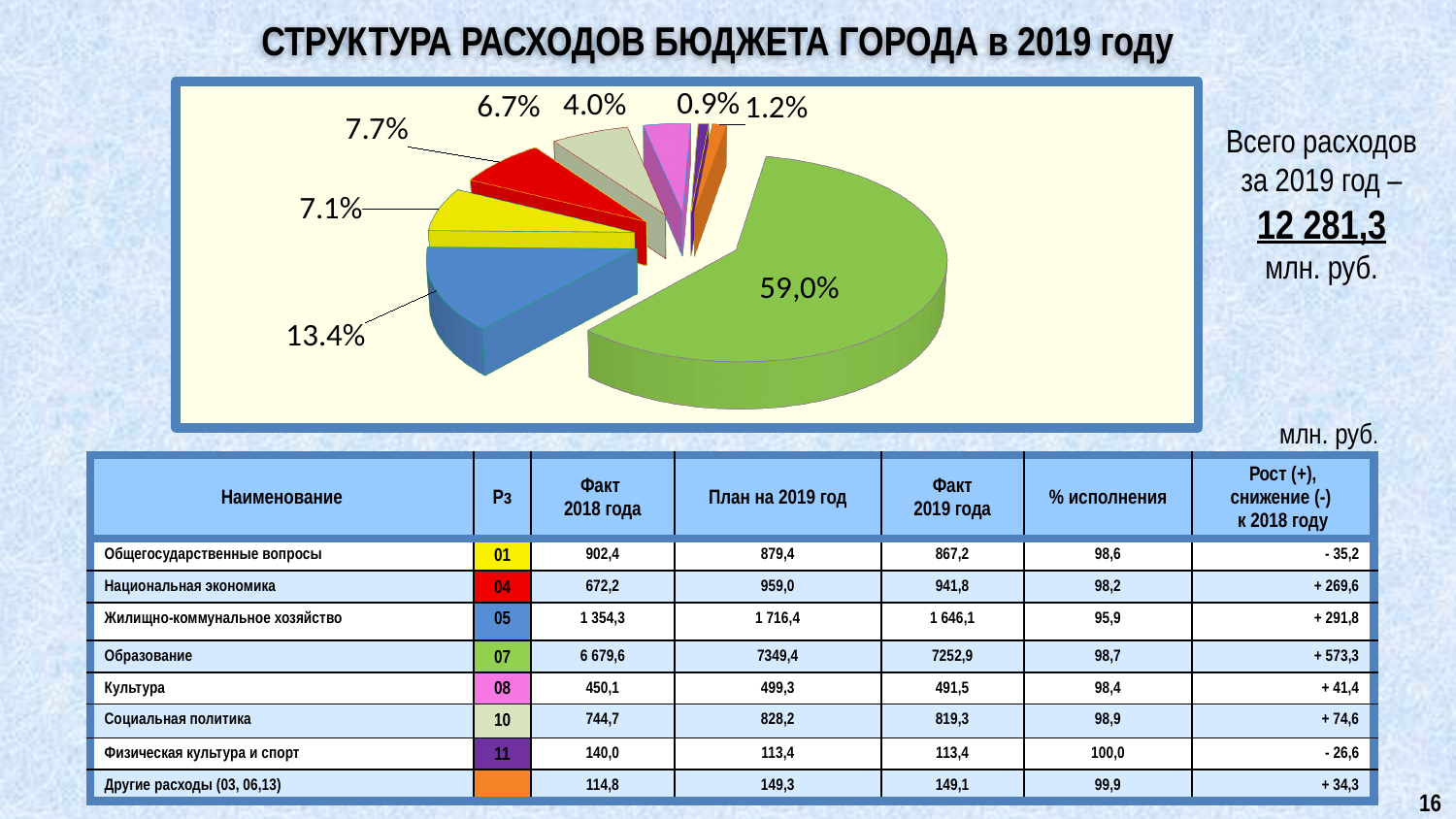
How many slices does the pie chart have? 8 What share does the green slice of the pie chart represent? 59,0% What share does the blue slice of the pie chart represent? 13.4% What is the title of the slide containing the pie chart? СТРУКТУРА РАСХОДОВ БЮДЖЕТА ГОРОДА в 2019 году Which slice is larger in the pie chart: the blue slice (13.4%) or the red slice (7.7%)? the blue slice (13.4%) What is the difference between the 6.7% slice and the 4.0% slice in the pie chart? 2.7% What share does the yellow slice of the pie chart represent? 7.1% What kind of chart is shown on the slide? pie chart What share does the red slice of the pie chart represent? 7.7% What is the share of the smallest slice in the pie chart? 0.9% What is the share of the largest slice in the pie chart? 59,0% What is the difference between the 7.7% slice and the 7.1% slice in the pie chart? 0.6%